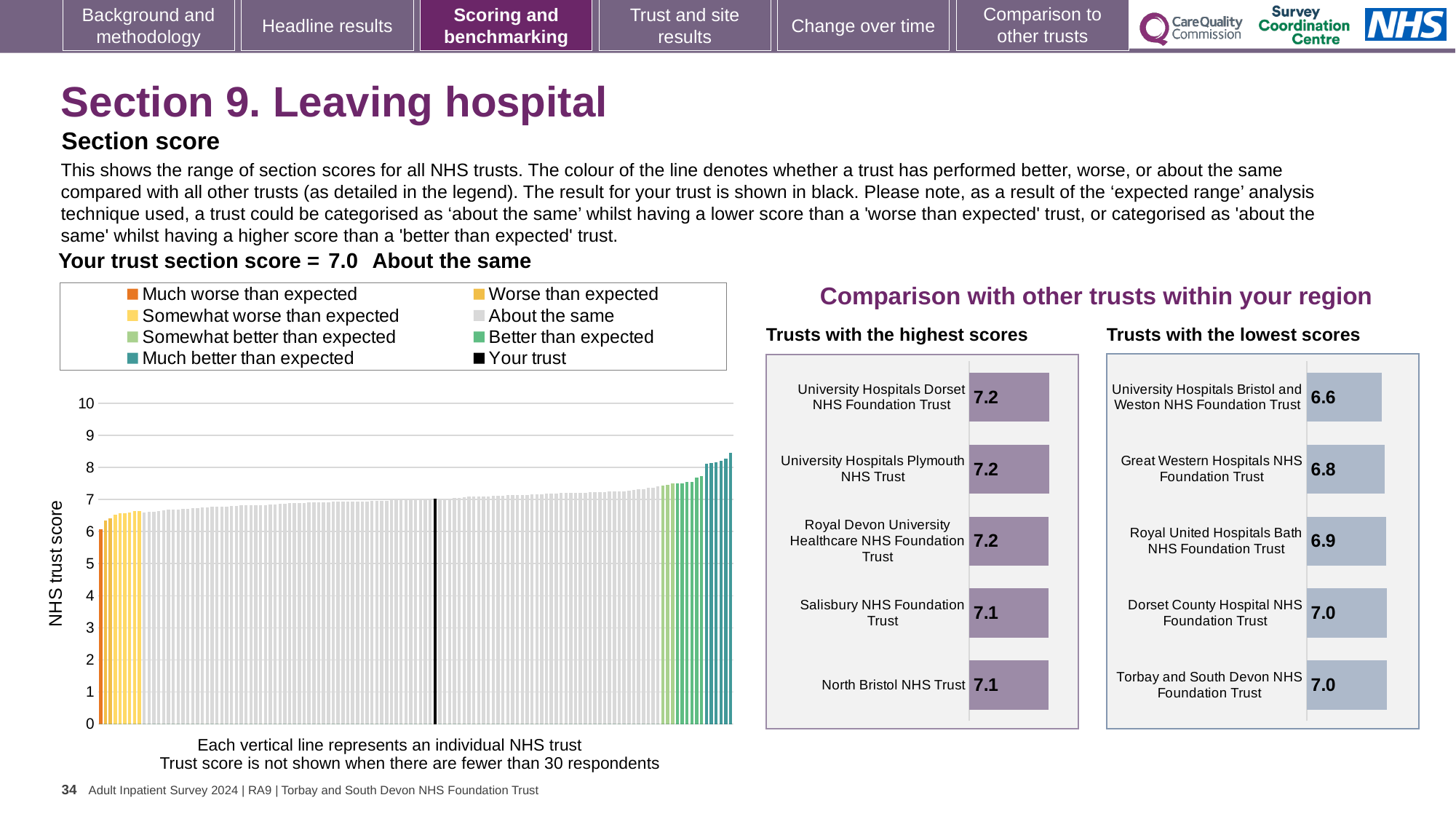
In the 'Trusts with the lowest scores' chart, which trust has the lowest score? University Hospitals Bristol and Weston NHS Foundation Trust What kind of chart is the 'Trusts with the lowest scores' chart? Bar chart How many trusts are listed in the 'Trusts with the highest scores' chart? 5 In the 'Trusts with the highest scores' chart, what is the score for North Bristol NHS Trust? 7.1 In the main NHS trust score chart on the left, what is the section score for your trust? 7.0 In the main NHS trust score chart on the left, do the trust scores rise or fall from left to right? Rise In the 'Trusts with the lowest scores' chart, what is the difference between the scores of Royal United Hospitals Bath NHS Foundation Trust and University Hospitals Bristol and Weston NHS Foundation Trust? 0.3 In the main NHS trust score chart on the left, is the value of the highest-scoring trust (rightmost bar) greater or less than 8? greater In the main NHS trust score chart on the left, what colour is used to show your trust according to the legend? Black In the 'Trusts with the lowest scores' chart, what is the score for Great Western Hospitals NHS Foundation Trust? 6.8 In the 'Trusts with the lowest scores' chart, which has the higher score: Great Western Hospitals NHS Foundation Trust or Royal United Hospitals Bath NHS Foundation Trust? Royal United Hospitals Bath NHS Foundation Trust In the 'Trusts with the highest scores' chart, what is the score for Salisbury NHS Foundation Trust? 7.1